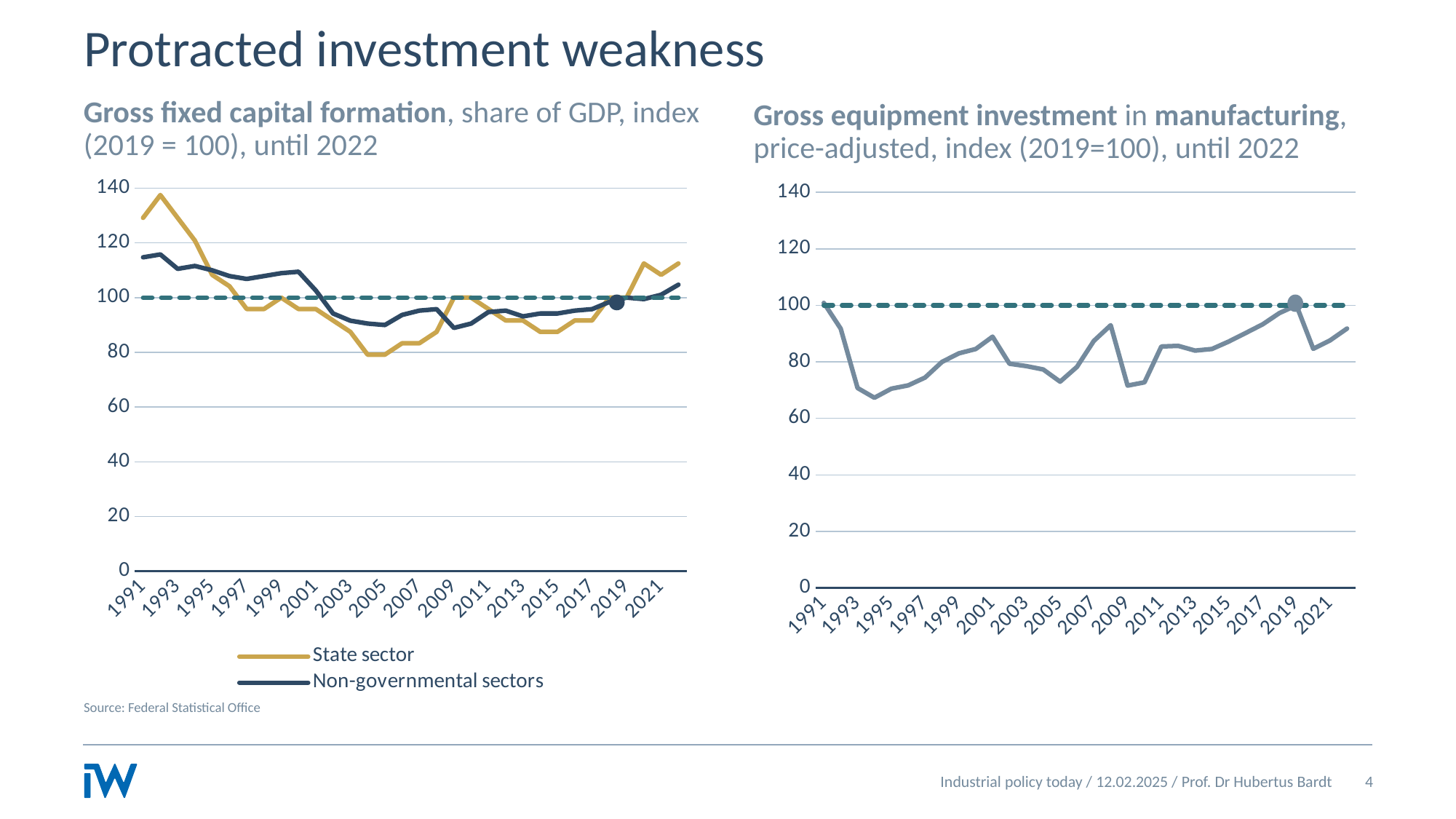
In the 'Gross fixed capital formation' chart, which series is shown in gold? State sector In the 'Gross fixed capital formation' chart, in which year does the State sector series reach its highest value? 1992 In the 'Gross fixed capital formation' chart, which series has the higher value in 1992, State sector or Non-governmental sectors? State sector At what index value is the horizontal dashed reference line drawn in both charts? 100 What kind of chart is the 'Gross fixed capital formation' chart on the left? line chart In the 'Gross fixed capital formation' chart, is the State sector value in 1992 greater or less than 120? greater In the 'Gross fixed capital formation' chart, which series has the higher value in 2005, State sector or Non-governmental sectors? Non-governmental sectors In the 'Gross fixed capital formation' chart, is the State sector value in 2005 greater or less than 100? less In the 'Gross equipment investment in manufacturing' chart, is the value in 1994 greater or less than 80? less How many series does the legend of the 'Gross fixed capital formation' chart list? 2 In the 'Gross equipment investment in manufacturing' chart, does the value rise or fall between 1991 and 1994? fall In the 'Gross equipment investment in manufacturing' chart, what is the index value marked by the dot in 2019? 100